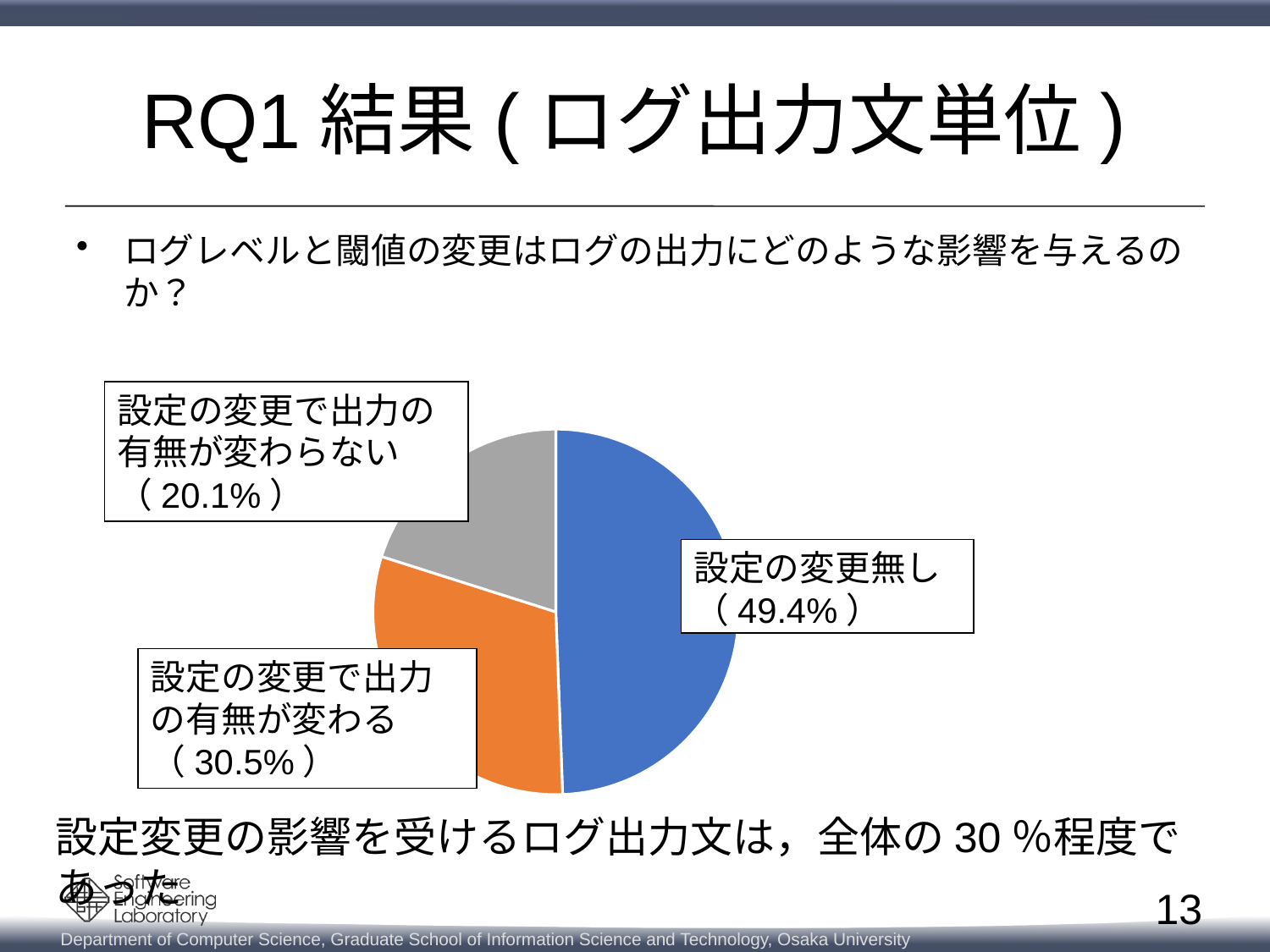
What share of the pie does 設定の変更無し have? 49.4% What kind of chart is shown on the slide? pie chart What colour is the slice for 設定の変更無し? blue How many slices does the pie chart have? 3 Which slice of the pie chart is the smallest? 設定の変更で出力の有無が変わらない What share of the pie does 設定の変更で出力の有無が変わる have? 30.5% What is the difference in percentage points between 設定の変更無し and 設定の変更で出力の有無が変わる? 18.9 What share of the pie does 設定の変更で出力の有無が変わらない have? 20.1% What colour is the slice for 設定の変更で出力の有無が変わる? orange What is the difference in percentage points between 設定の変更で出力の有無が変わる and 設定の変更で出力の有無が変わらない? 10.4 Which slice of the pie chart is the largest? 設定の変更無し Which is larger: the share for 設定の変更で出力の有無が変わる or the share for 設定の変更で出力の有無が変わらない? 設定の変更で出力の有無が変わる